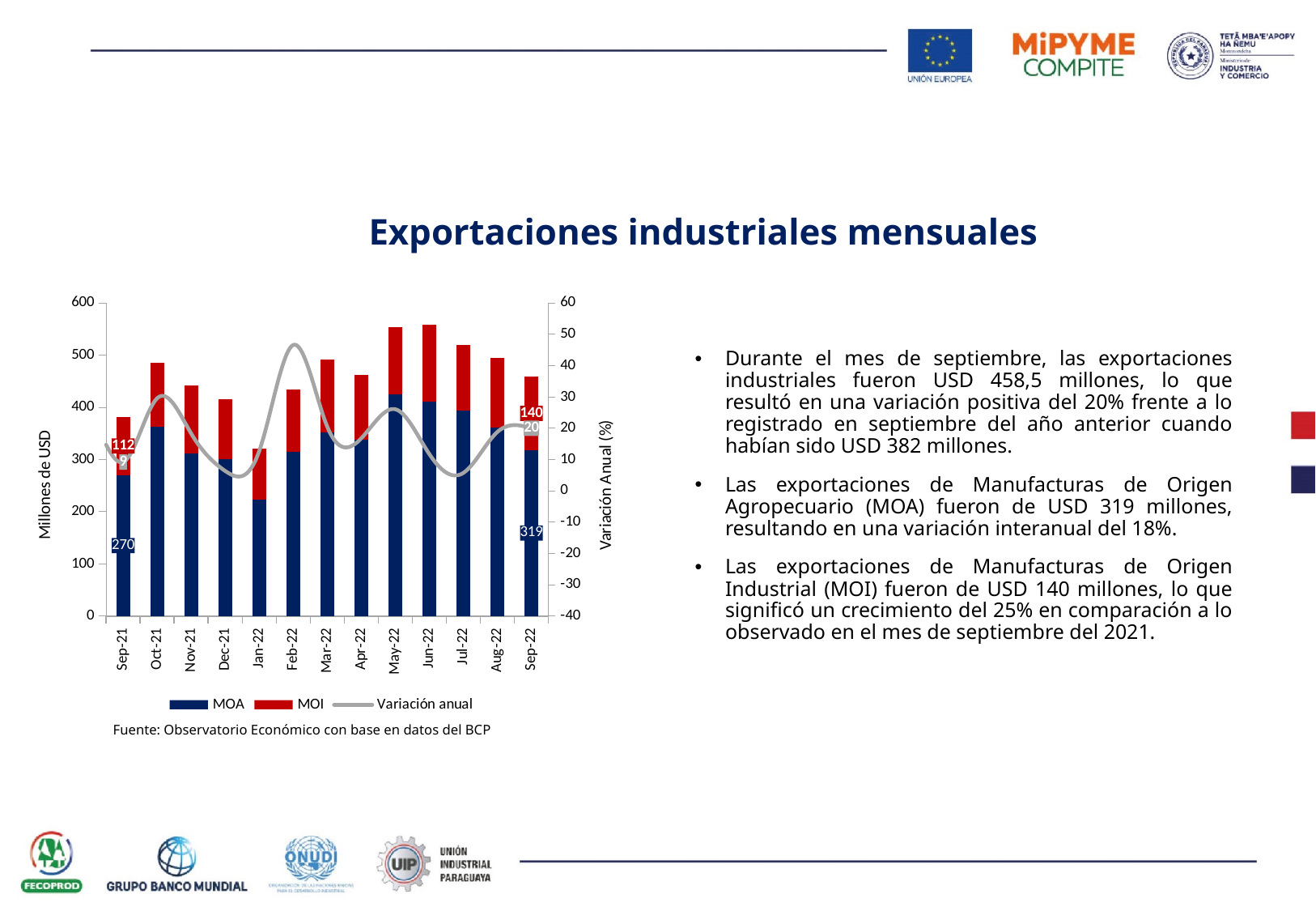
Is the MOA value for Oct-21 greater or less than 300? greater What is the MOI value for Sep-22? 140 What is the MOA value for Sep-22? 319 What is the MOA value for Sep-21? 270 What is the total of the stacked bar (MOA plus MOI) for Sep-22? 459 Which month has the lowest MOA value? Jan-22 What is the title of the left vertical axis? Millones de USD How many months are shown on the x axis? 13 What is the Variación anual value for Sep-22? 20 How many series does the legend list? 3 What is the difference between the MOA value for Sep-22 and the MOA value for Sep-21? 49 What is the MOI value for Sep-21? 112